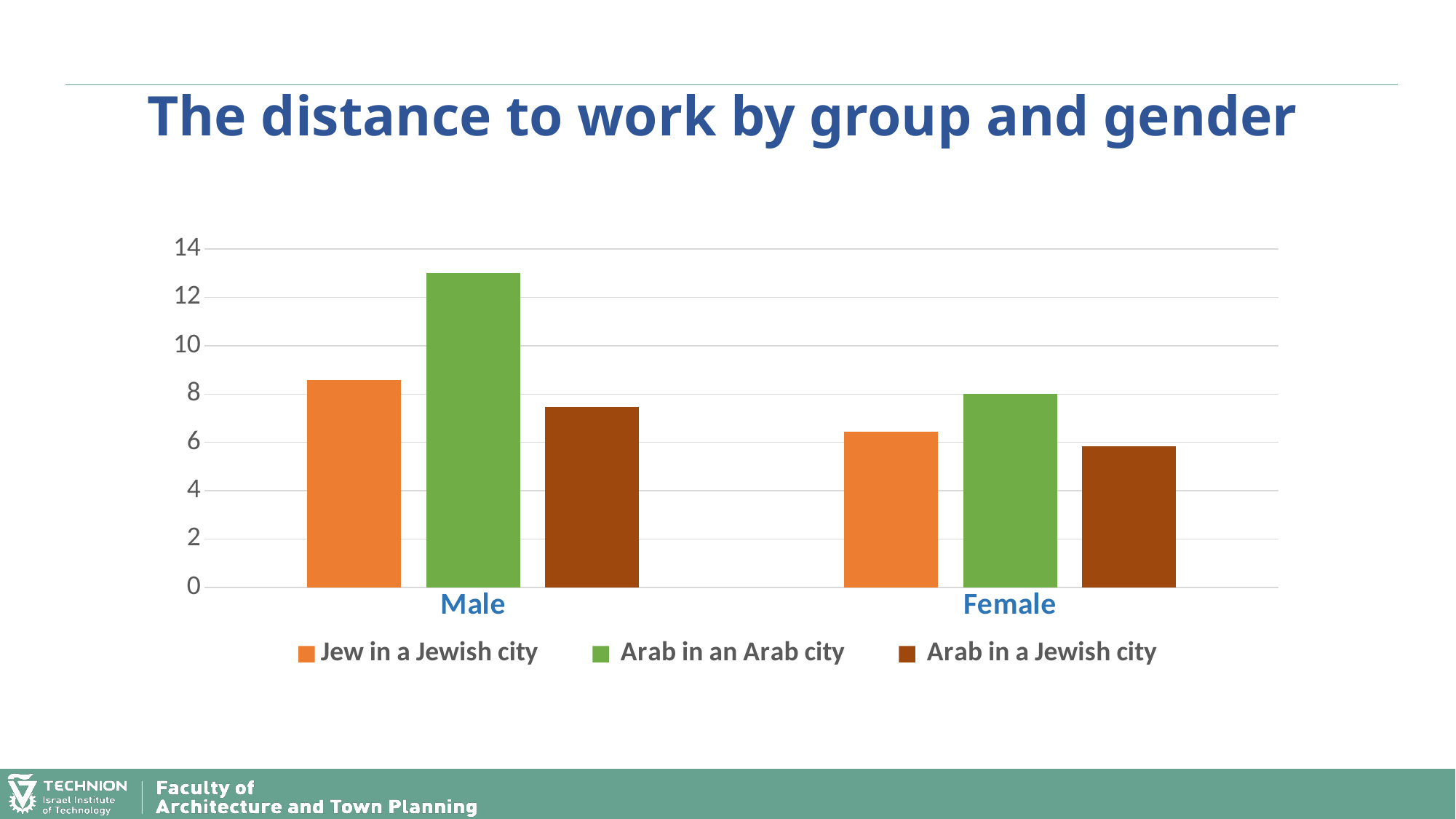
For Male, which is larger: Jew in a Jewish city or Arab in a Jewish city? Jew in a Jewish city What kind of chart is shown on the slide? bar chart Is the value for Jew in a Jewish city (Female) greater or less than 8? less How many gender categories are shown on the x axis? 2 For Arab in an Arab city, which is larger: Male or Female? Male Which group has the highest value for Male? Arab in an Arab city What is the title of the chart? The distance to work by group and gender Is the value for Arab in a Jewish city (Male) greater or less than 6? greater Which bar is the tallest in the whole chart? Arab in an Arab city, Male Is the value for Arab in an Arab city (Male) greater or less than 12? greater How many series does the legend list? 3 Which group has the lowest value for Female? Arab in a Jewish city